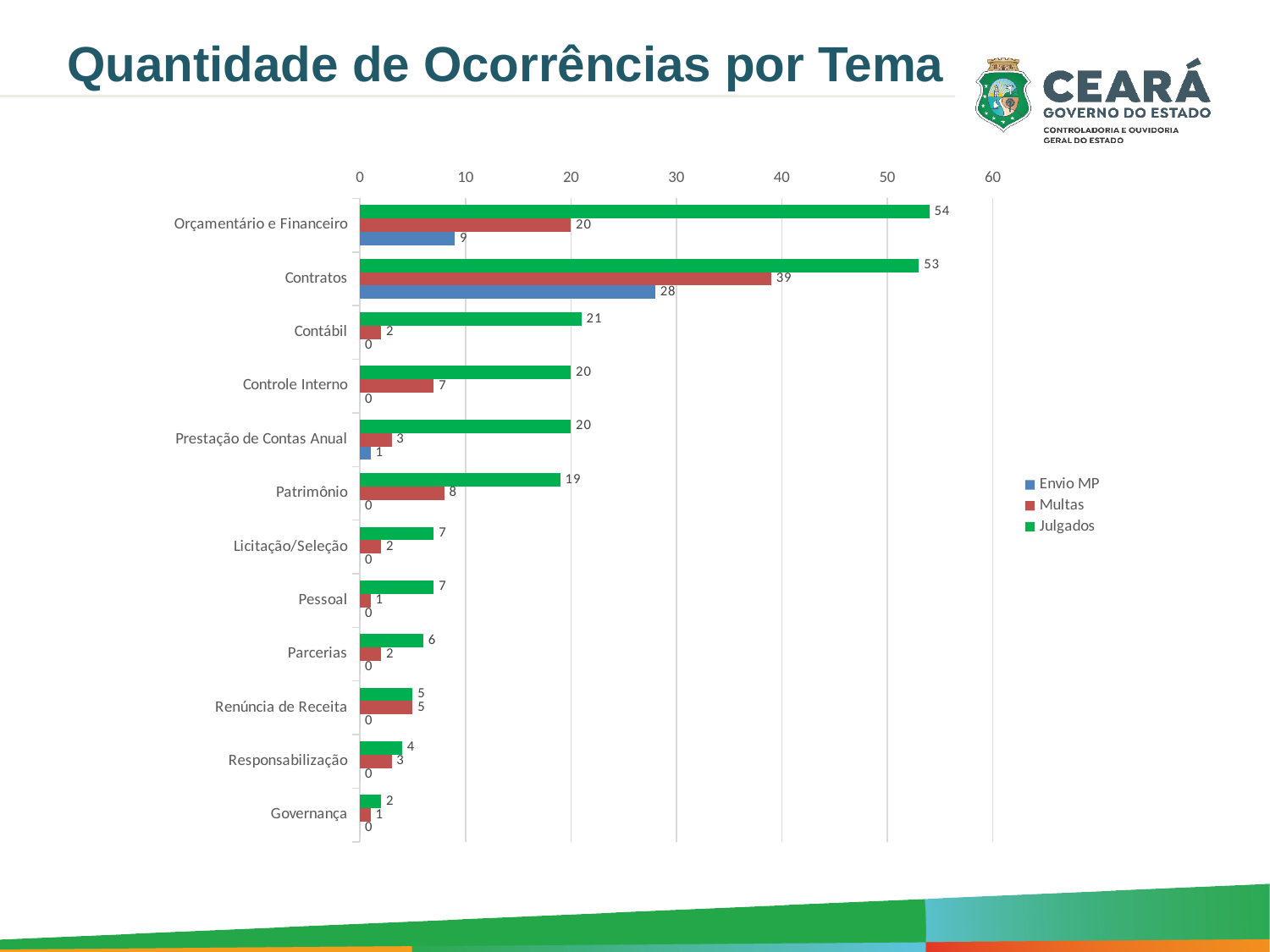
What kind of chart is shown on the slide? Bar chart What is the Envio MP value for Contratos? 28 What is the Multas value for Contratos? 39 How many series does the legend list? 3 What is the difference between the Multas values for Contratos and Orçamentário e Financeiro? 19 Which category has the lowest Julgados value? Governança What is the title of the chart? Quantidade de Ocorrências por Tema How many categories are shown on the chart? 12 What is the Julgados value for Orçamentário e Financeiro? 54 Is the Julgados value for Contratos greater or less than 50? greater Which category has the highest Julgados value? Orçamentário e Financeiro Which is larger, the Envio MP value for Contratos or the Envio MP value for Orçamentário e Financeiro? Contratos